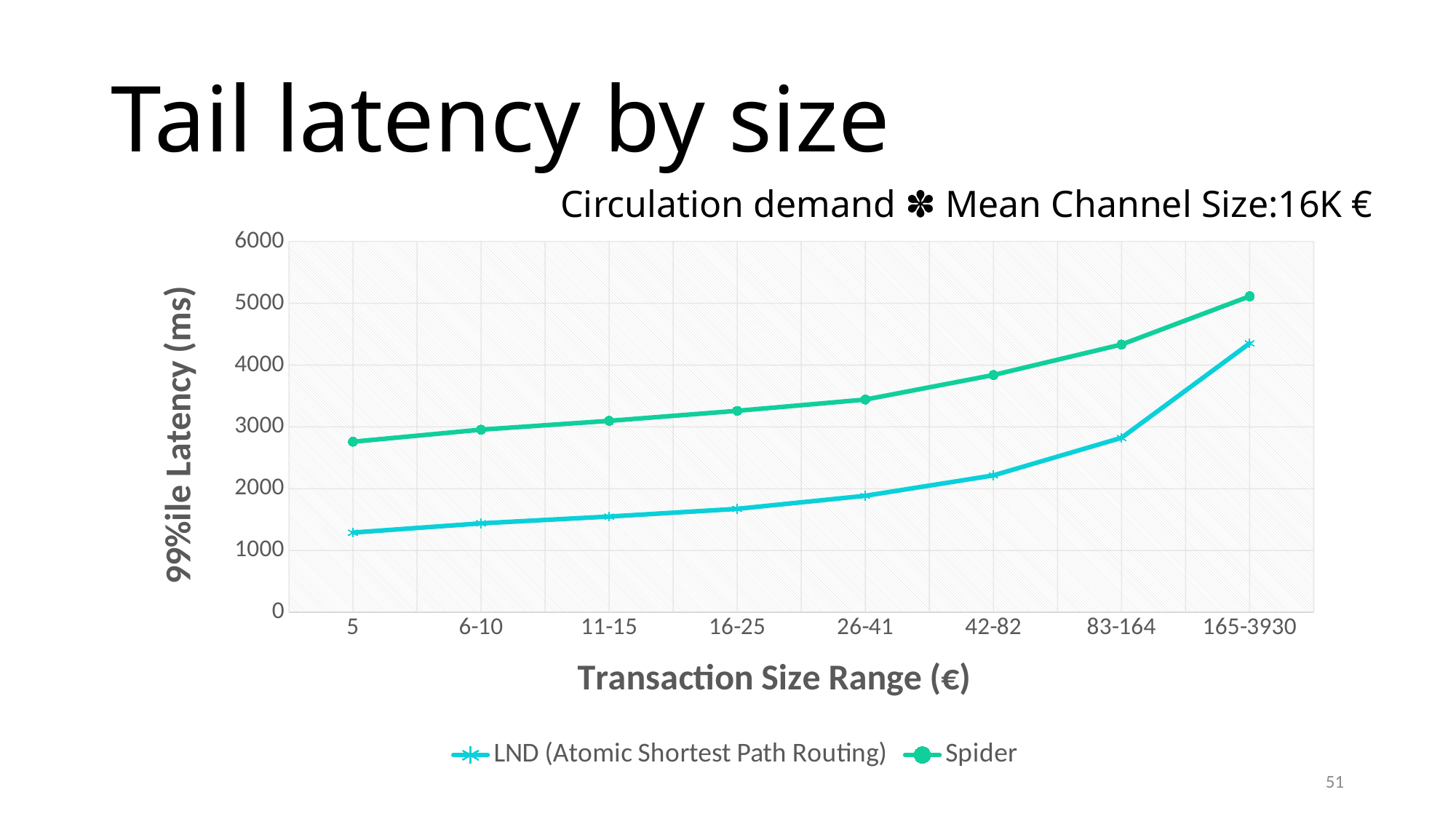
How many series does the legend list? 2 Do the 99%ile latency values for Spider rise or fall as the transaction size range increases along the x axis? rise Which series has the higher 99%ile latency for the 26-41 transaction size range, LND (Atomic Shortest Path Routing) or Spider? Spider Is the 99%ile latency for LND (Atomic Shortest Path Routing) at transaction size range 165-3930 greater or less than 4000? greater What kind of chart is shown on the slide? line chart Which transaction size range has the highest 99%ile latency for Spider? 165-3930 What is the label of the y axis? 99%ile Latency (ms) Is the 99%ile latency for Spider at transaction size 5 greater or less than 2000? greater How many transaction size ranges are plotted along the x axis? 8 Which transaction size range has the lowest 99%ile latency for LND (Atomic Shortest Path Routing)? 5 Is the 99%ile latency for LND (Atomic Shortest Path Routing) at transaction size range 83-164 greater or less than 3000? less